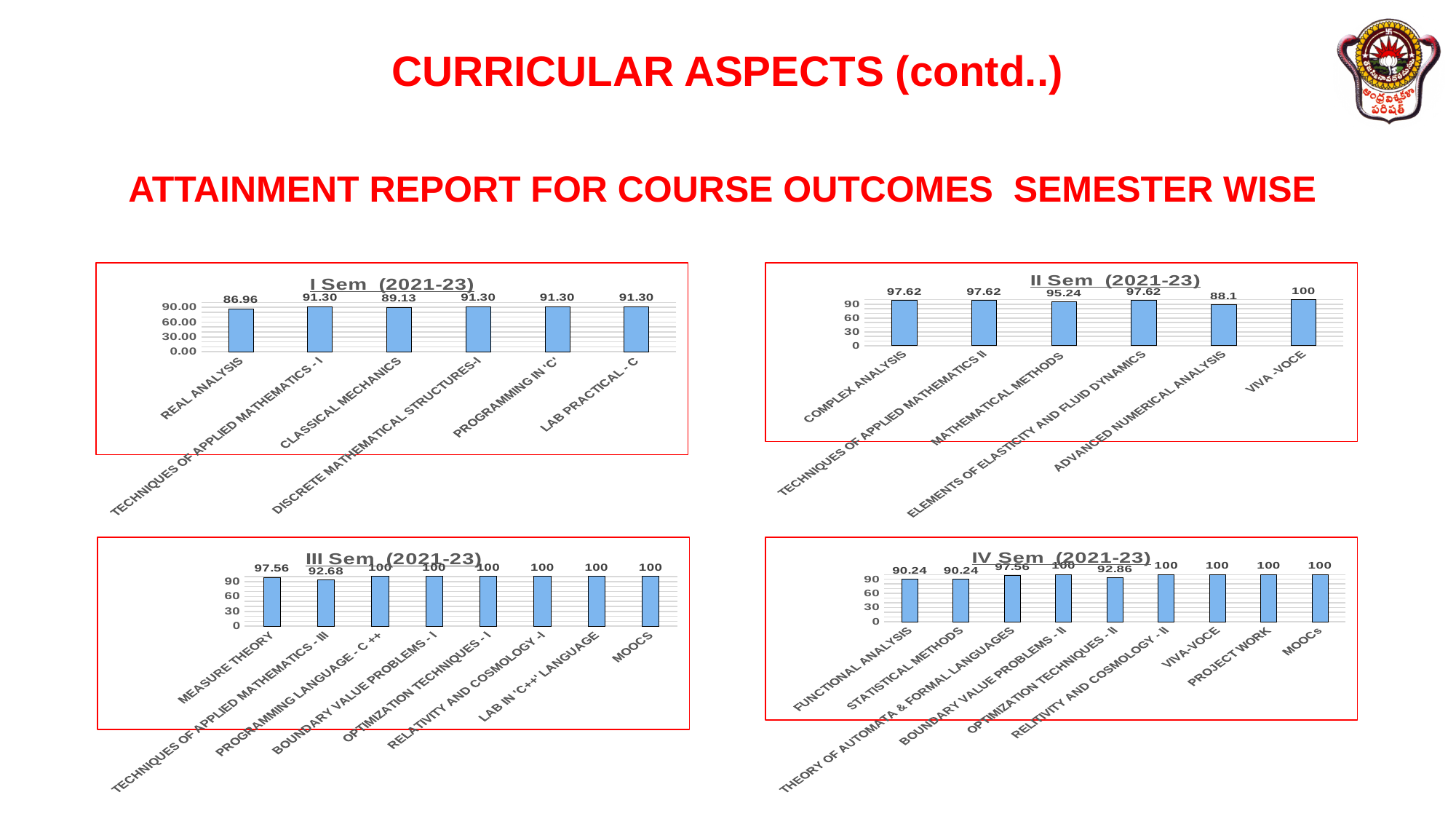
In the I Sem (2021-23) chart, what is the value for REAL ANALYSIS? 86.96 In the I Sem (2021-23) chart, what is the difference between TECHNIQUES OF APPLIED MATHEMATICS - I and CLASSICAL MECHANICS? 2.17 In the II Sem (2021-23) chart, what is the value for ADVANCED NUMERICAL ANALYSIS? 88.1 How many courses are shown in the III Sem (2021-23) chart? 8 In the I Sem (2021-23) chart, which course has the lowest value? REAL ANALYSIS In the III Sem (2021-23) chart, what is the value for TECHNIQUES OF APPLIED MATHEMATICS - III? 92.68 What type of chart is the IV Sem (2021-23) chart? Bar chart How many courses are shown in the II Sem (2021-23) chart? 6 In the IV Sem (2021-23) chart, what is the difference between THEORY OF AUTOMATA & FORMAL LANGUAGES and FUNCTIONAL ANALYSIS? 7.32 In the IV Sem (2021-23) chart, what is the value for OPTIMIZATION TECHNIQUES - II? 92.86 In the II Sem (2021-23) chart, which course has the highest value? VIVA-VOCE In the II Sem (2021-23) chart, which is larger: MATHEMATICAL METHODS or COMPLEX ANALYSIS? COMPLEX ANALYSIS